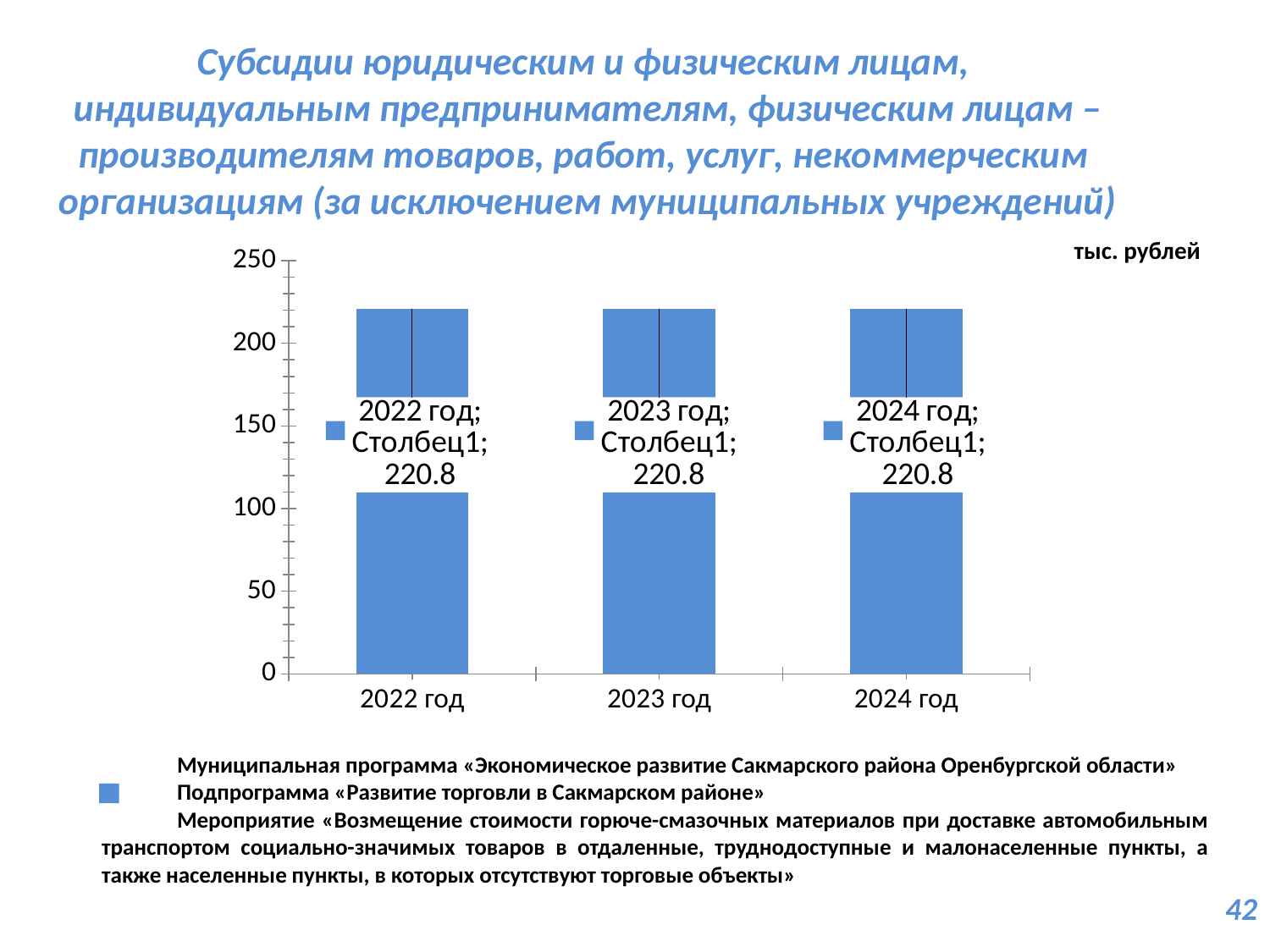
Do the values rise, fall, or stay the same from 2022 год to 2024 год? Stay the same What is the value for 2023 год? 220.8 What is the difference between the values for 2022 год and 2024 год? 0 What unit of measurement is indicated for the chart values? тыс. рублей What is the value for 2022 год? 220.8 What is the name of the data series shown in the data labels? Столбец1 What is the value for 2024 год? 220.8 How many bars (categories) are shown in the chart? 3 Which is larger, the value for 2022 год or the value for 2023 год? They are equal What kind of chart is shown on the slide? Bar chart Is the value for 2023 год greater or less than 200? greater Is the value for 2024 год greater or less than 250? less